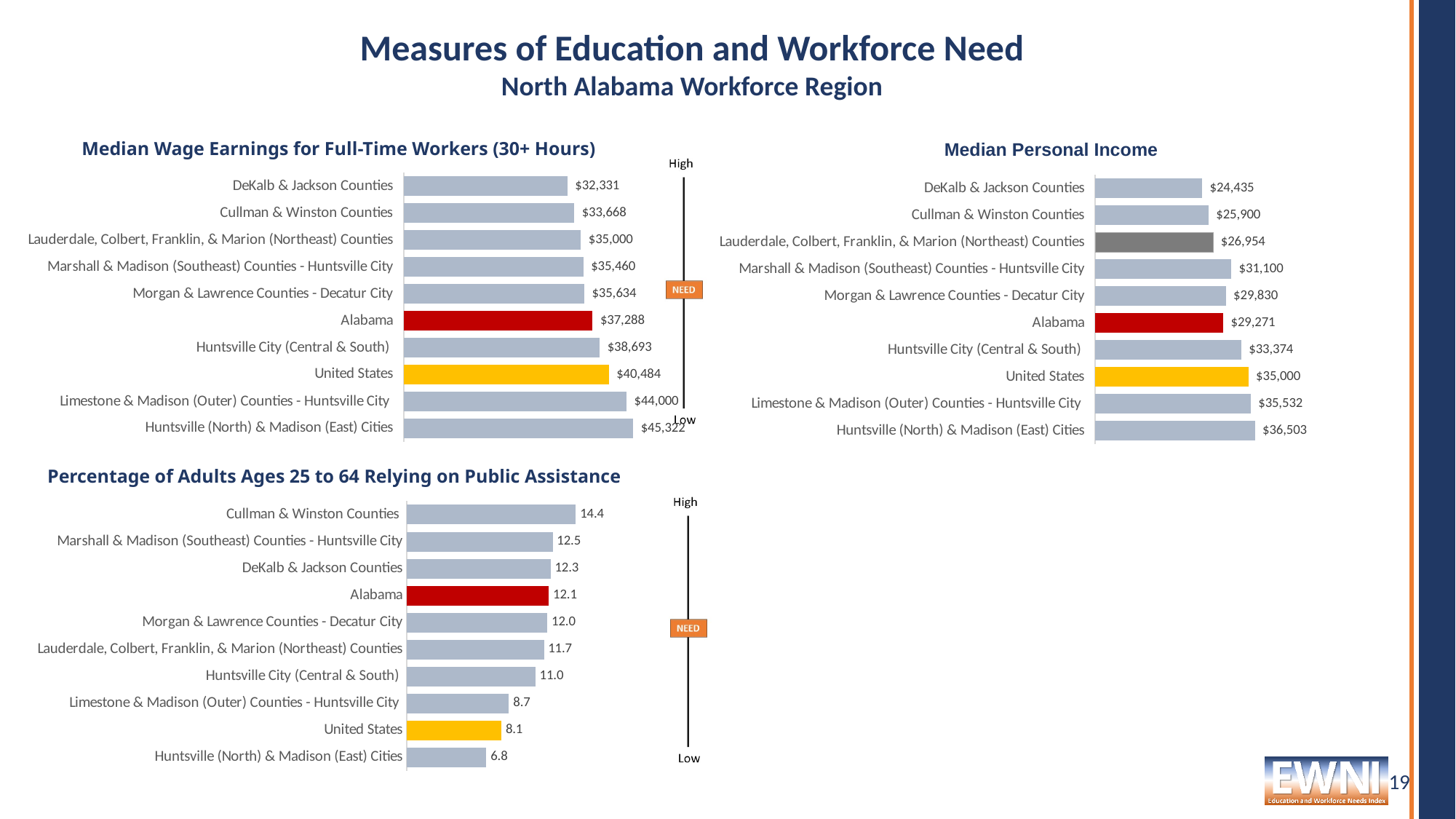
In the Median Wage Earnings for Full-Time Workers (30+ Hours) chart, which category has the highest value? Huntsville (North) & Madison (East) Cities How many categories are shown in the Median Personal Income chart? 10 In the Median Wage Earnings for Full-Time Workers (30+ Hours) chart, what is the value for Alabama? $37,288 What type of chart is the Percentage of Adults Ages 25 to 64 Relying on Public Assistance chart? Bar chart In the Median Personal Income chart, what is the value for Huntsville City (Central & South)? $33,374 In the Median Wage Earnings for Full-Time Workers (30+ Hours) chart, which category has the lowest value? DeKalb & Jackson Counties In the Percentage of Adults Ages 25 to 64 Relying on Public Assistance chart, what is the difference between Cullman & Winston Counties and Huntsville (North) & Madison (East) Cities? 7.6 In the Median Personal Income chart, what is the difference between Huntsville (North) & Madison (East) Cities and DeKalb & Jackson Counties? $12,068 In the Percentage of Adults Ages 25 to 64 Relying on Public Assistance chart, which category has the highest value? Cullman & Winston Counties In the Median Wage Earnings for Full-Time Workers (30+ Hours) chart, what is the difference between the United States and Alabama values? $3,196 In the Percentage of Adults Ages 25 to 64 Relying on Public Assistance chart, what is the value for the United States? 8.1 In the Median Personal Income chart, which is larger, Morgan & Lawrence Counties - Decatur City or Alabama? Morgan & Lawrence Counties - Decatur City